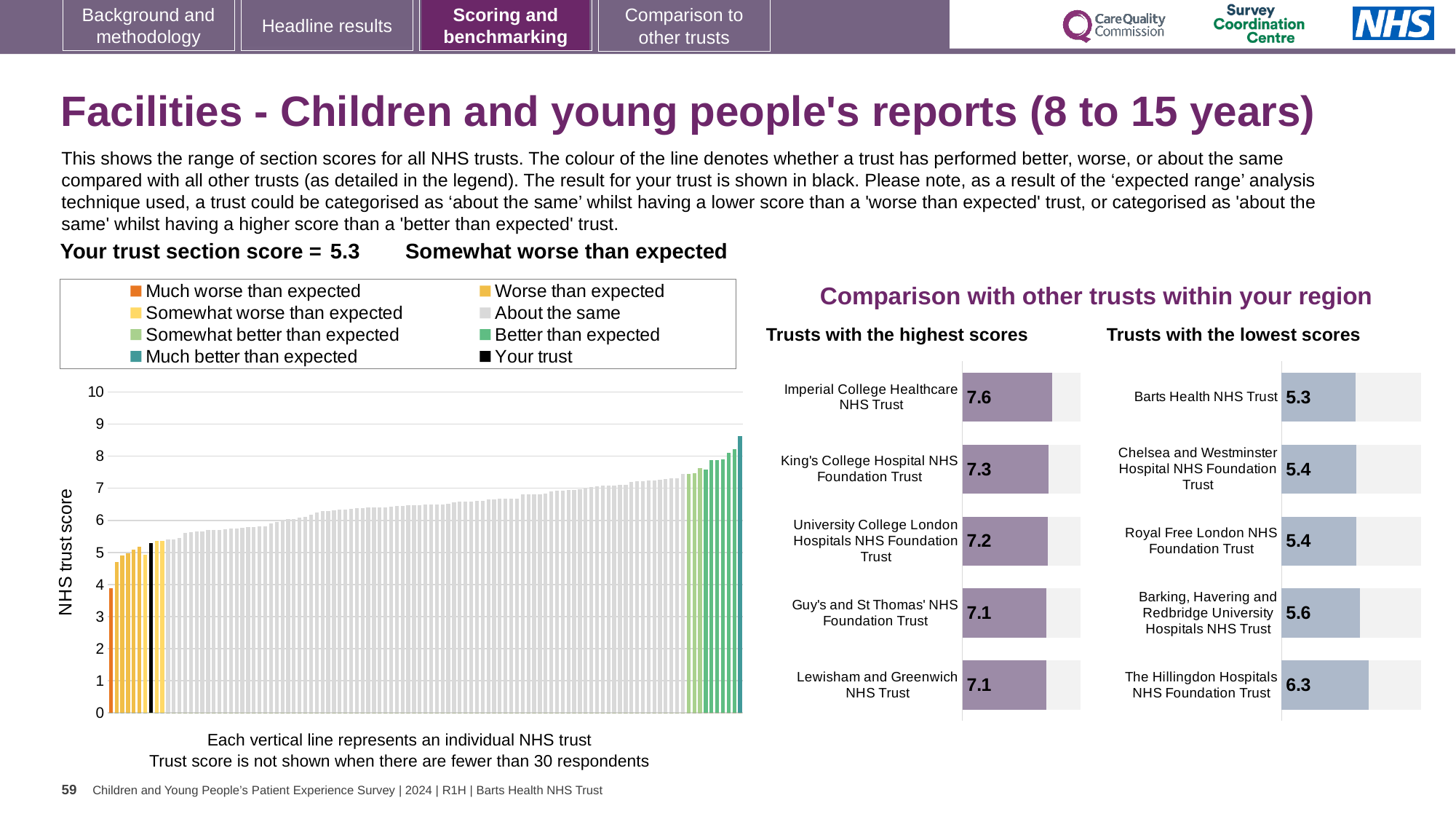
How many entries does the legend of the main chart on the left list? 8 What kind of chart is the main chart on the left of the slide? bar chart In the main chart on the left, do the bar values rise or fall from left to right? rise In the main chart on the left, is the value of the highest bar greater or less than 8? greater In the 'Trusts with the lowest scores' chart, what is the difference between the scores of The Hillingdon Hospitals NHS Foundation Trust and Barts Health NHS Trust? 1.0 In the 'Trusts with the highest scores' chart, which trust has the highest score? Imperial College Healthcare NHS Trust In the 'Trusts with the lowest scores' chart, which trust has the lowest score? Barts Health NHS Trust In the 'Trusts with the lowest scores' chart, what is the score for The Hillingdon Hospitals NHS Foundation Trust? 6.3 In the 'Trusts with the highest scores' chart, which has the larger score: King's College Hospital NHS Foundation Trust or University College London Hospitals NHS Foundation Trust? King's College Hospital NHS Foundation Trust In the 'Trusts with the highest scores' chart, what is the difference between the scores of Imperial College Healthcare NHS Trust and King's College Hospital NHS Foundation Trust? 0.3 In the 'Trusts with the highest scores' chart, what is the score for Imperial College Healthcare NHS Trust? 7.6 How many trusts are shown in the 'Trusts with the lowest scores' chart? 5